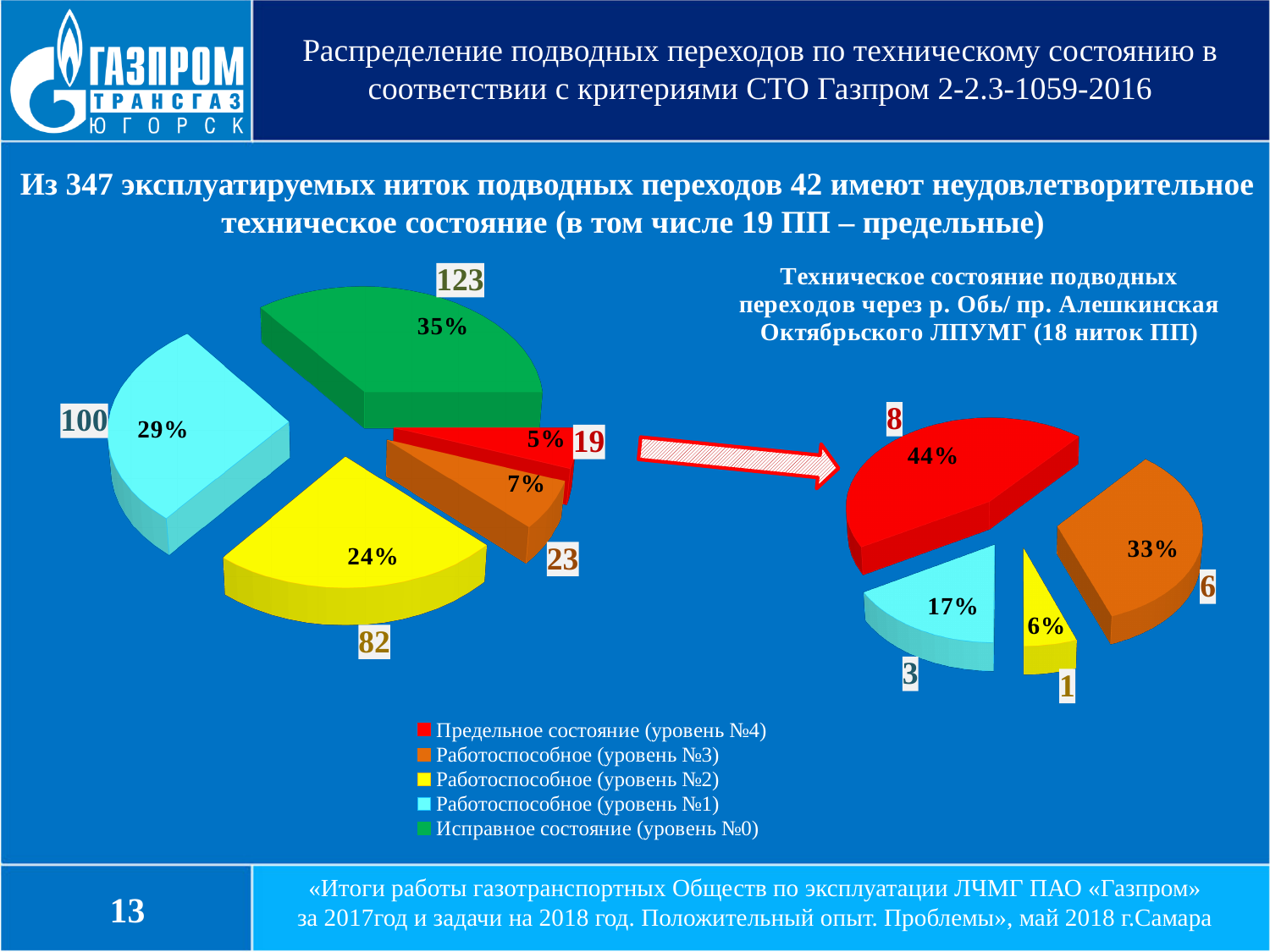
How many entries does the legend list? 5 On the left pie chart, what is the difference between the values for 'Работоспособное (уровень №2)' and 'Работоспособное (уровень №3)'? 59 On the right pie chart (crossings through the Ob river), which category has the smallest value? Работоспособное (уровень №2) On the left pie chart, which category has the smallest value? Предельное состояние (уровень №4) How many slices does the right pie chart (crossings through the Ob river) have? 4 On the right pie chart (crossings through the Ob river), what is the value for 'Предельное состояние (уровень №4)'? 8 On the left pie chart, how many underwater crossings are in the 'Исправное состояние (уровень №0)' category? 123 On the left pie chart, what percentage share is shown for 'Работоспособное (уровень №1)'? 29% On the right pie chart (crossings through the Ob river), what percentage share is shown for 'Работоспособное (уровень №3)'? 33% On the left pie chart, which is larger: 'Работоспособное (уровень №1)' or 'Работоспособное (уровень №2)'? Работоспособное (уровень №1) What type of chart is used on the left side of the slide? Pie chart On the left pie chart, which category has the largest value? Исправное состояние (уровень №0)